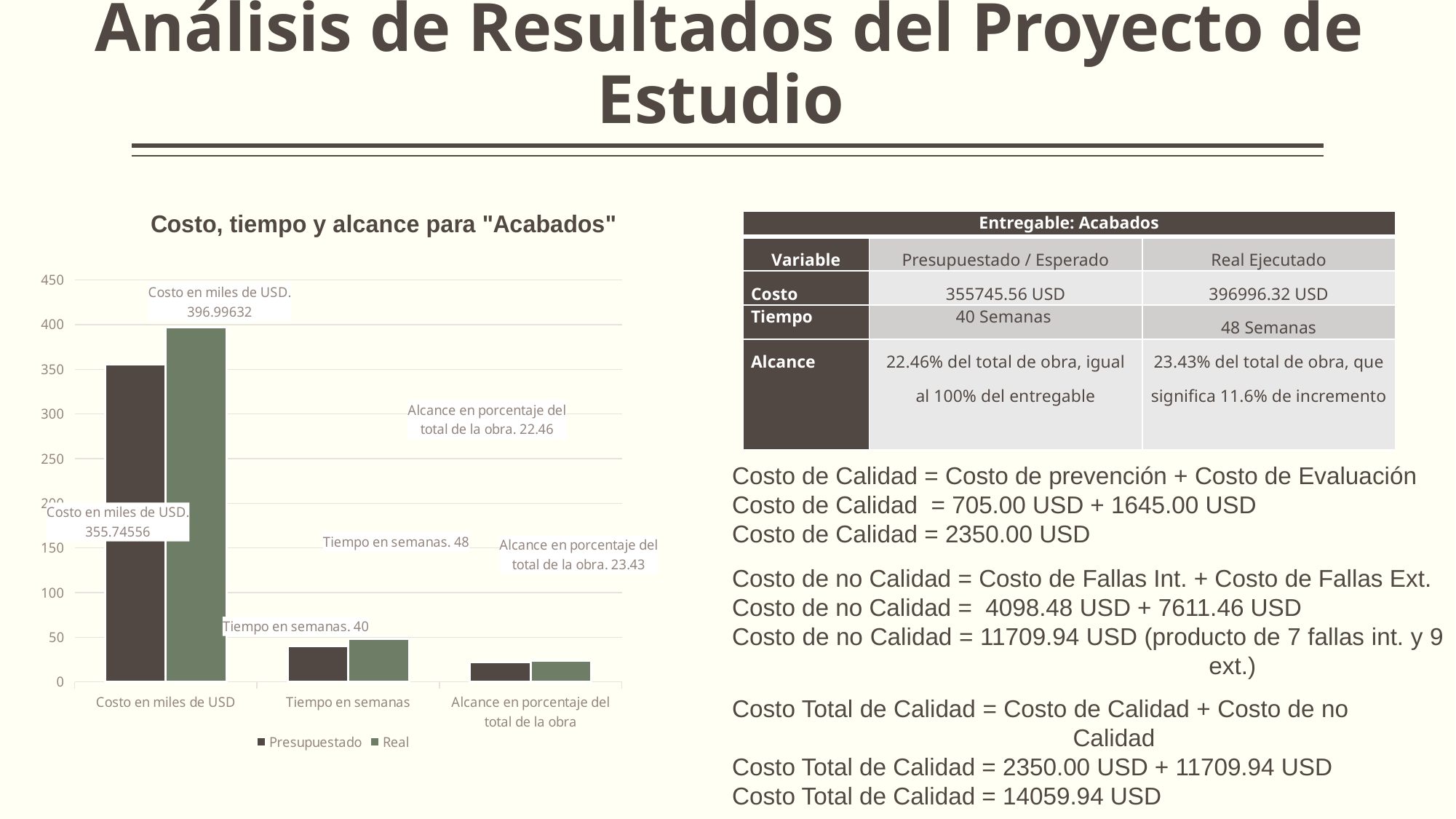
What is the difference between the Real and Presupuestado values for Tiempo en semanas? 8 Is the Real value for Costo en miles de USD greater or less than 350? greater What is the Real value for Tiempo en semanas? 48 How many series does the chart legend list? 2 What is the Presupuestado value for Costo en miles de USD? 355.74556 Which category has the highest Real value? Costo en miles de USD What is the title of the chart? Costo, tiempo y alcance para "Acabados" What is the Real value for Costo en miles de USD? 396.99632 How many categories are shown on the x axis of the chart? 3 Which category has the lowest Presupuestado value? Alcance en porcentaje del total de la obra What is the Presupuestado value for Alcance en porcentaje del total de la obra? 22.46 What kind of chart is shown on the slide? Bar chart